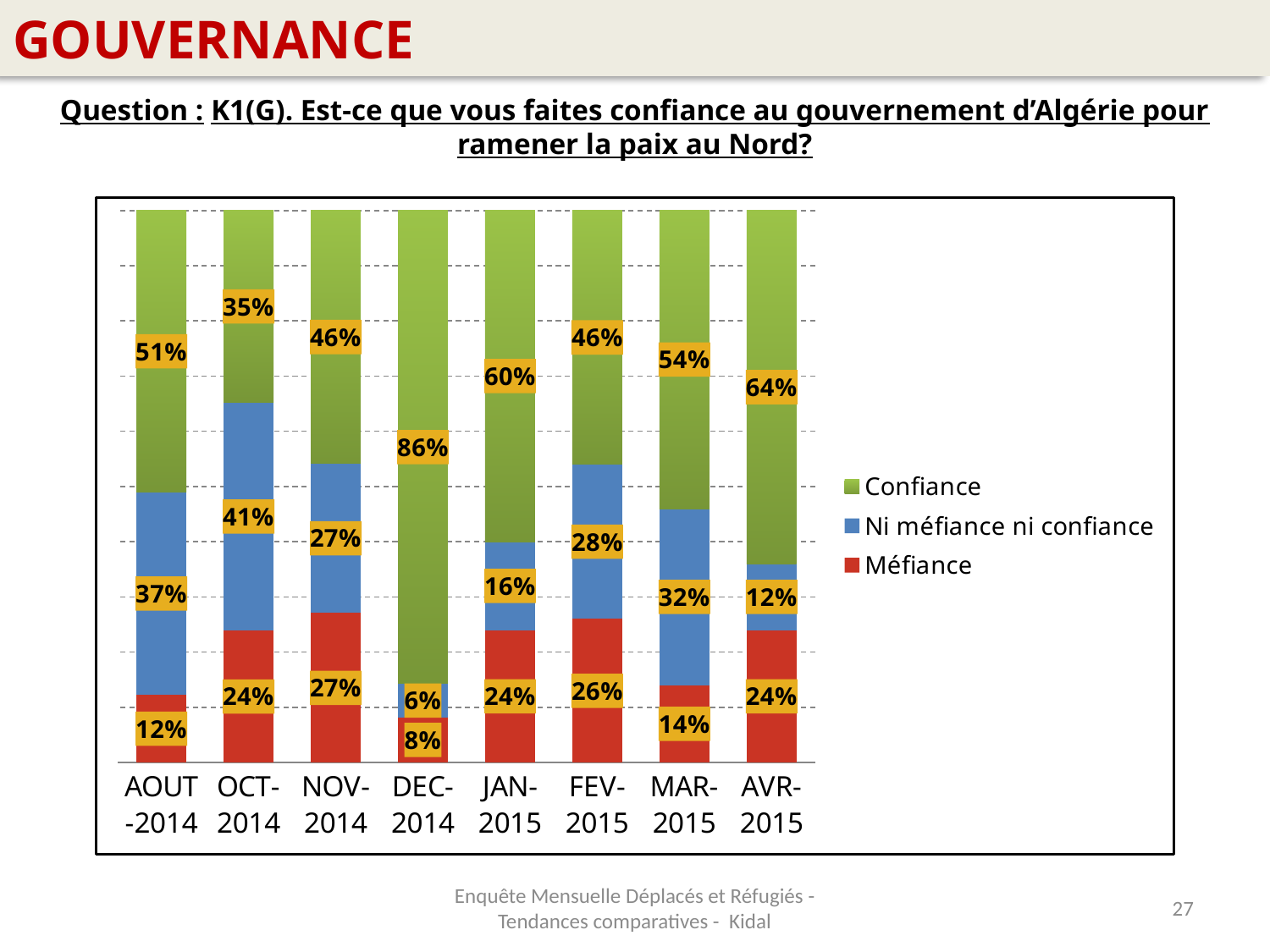
What is the value for Confiance in DEC-2014? 86% What is the value for Confiance in AVR-2015? 64% In which month is the Confiance value lowest? OCT-2014 What kind of chart is shown on the slide? Stacked bar chart In which month is the Méfiance value lowest? DEC-2014 In which month is the Confiance value highest? DEC-2014 How many series does the legend list? 3 What is the value for Ni méfiance ni confiance in MAR-2015? 32% How many months are shown on the x axis? 8 What is the value for Méfiance in AOUT-2014? 12% What is the difference between the Confiance values for AVR-2015 and JAN-2015? 4% Which is larger, the Méfiance value in OCT-2014 or in MAR-2015? OCT-2014